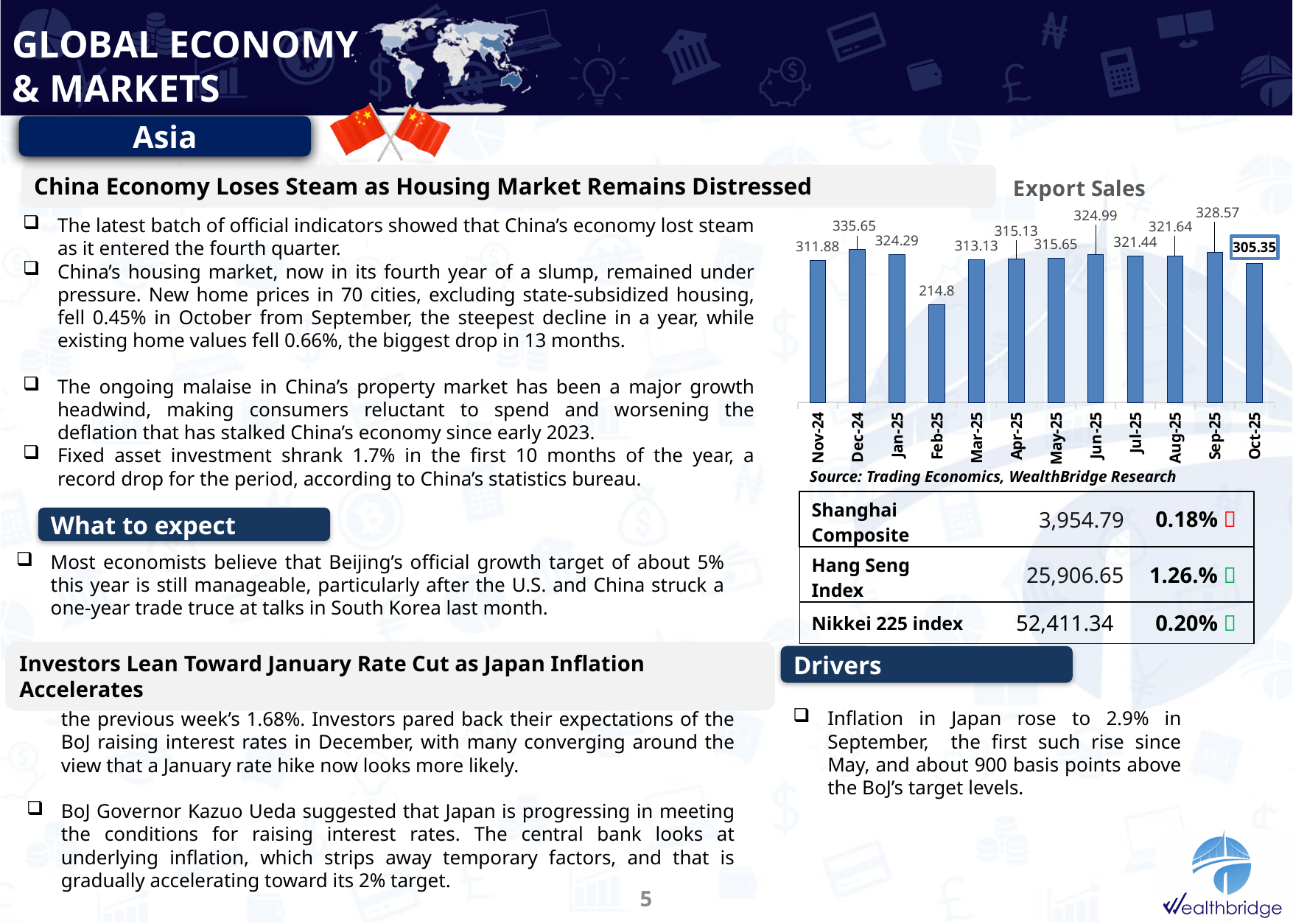
What type of chart is the Export Sales chart? bar chart What is the Export Sales value for Oct-25? 305.35 What is the difference between the Export Sales values for Sep-25 and Oct-25? 23.22 How many months are plotted in the Export Sales chart? 12 Which is larger, the Export Sales value for Jan-25 or for Mar-25? Jan-25 What is the source cited below the Export Sales chart? Trading Economics, WealthBridge Research What is the Export Sales value for Dec-24? 335.65 Which month has the lowest Export Sales value? Feb-25 What is the difference between the Export Sales values for Dec-24 and Feb-25? 120.85 What is the Export Sales value for Feb-25? 214.8 Which month has the highest Export Sales value? Dec-24 What is the title of the chart on the slide? Export Sales